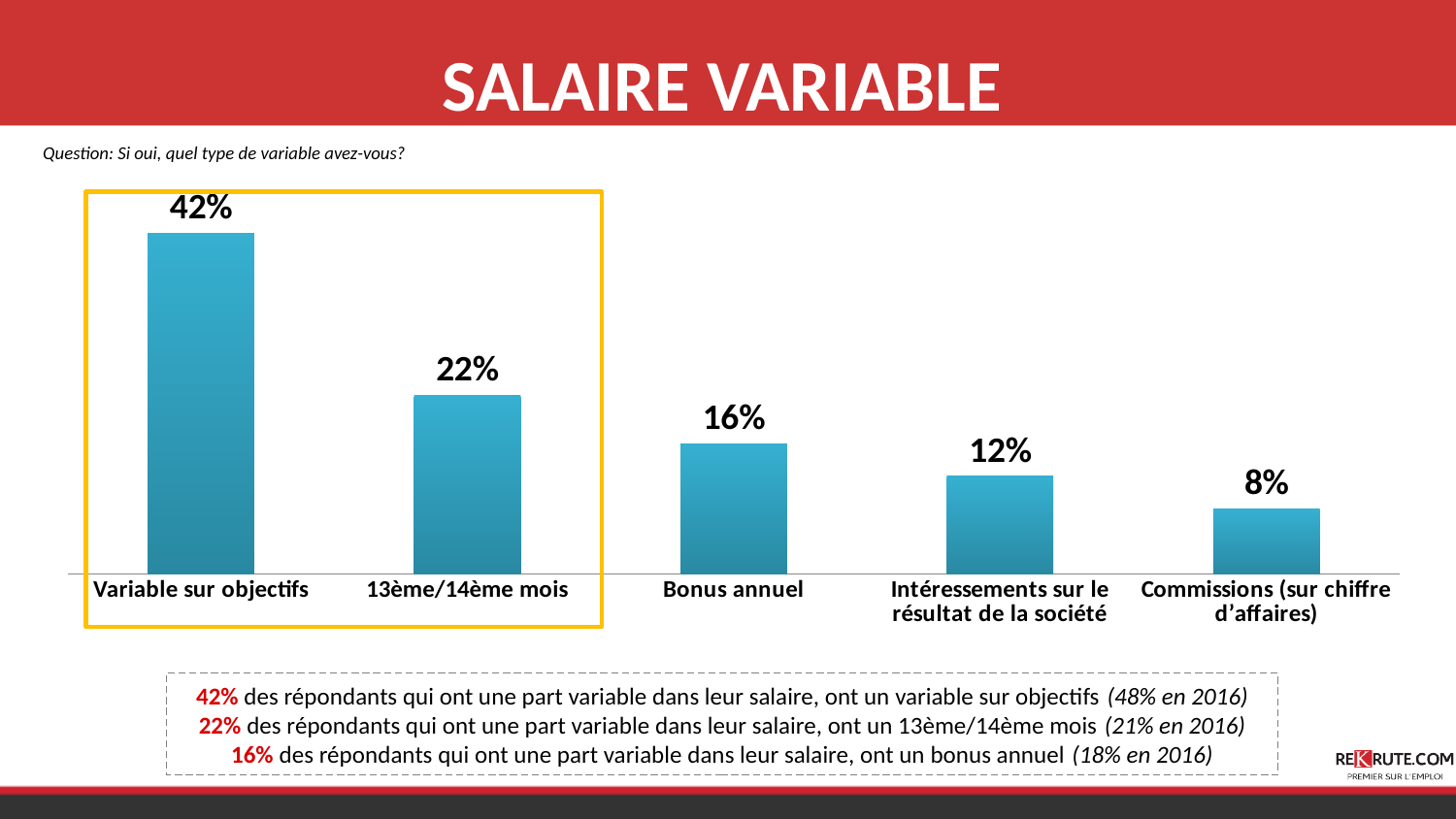
What is the value for 'Variable sur objectifs'? 42% What is the value for 'Bonus annuel'? 16% Do the values rise or fall from left to right along the x axis? Fall Which category has the highest value? Variable sur objectifs Which category has the lowest value? Commissions (sur chiffre d'affaires) What is the difference between 'Variable sur objectifs' and '13ème/14ème mois'? 20% How many categories are shown in the chart? 5 Which is larger: 'Bonus annuel' or 'Intéressements sur le résultat de la société'? Bonus annuel What kind of chart is shown on the slide? Bar chart What is the value for '13ème/14ème mois'? 22% What is the value for 'Commissions (sur chiffre d'affaires)'? 8% What is the value for 'Intéressements sur le résultat de la société'? 12%